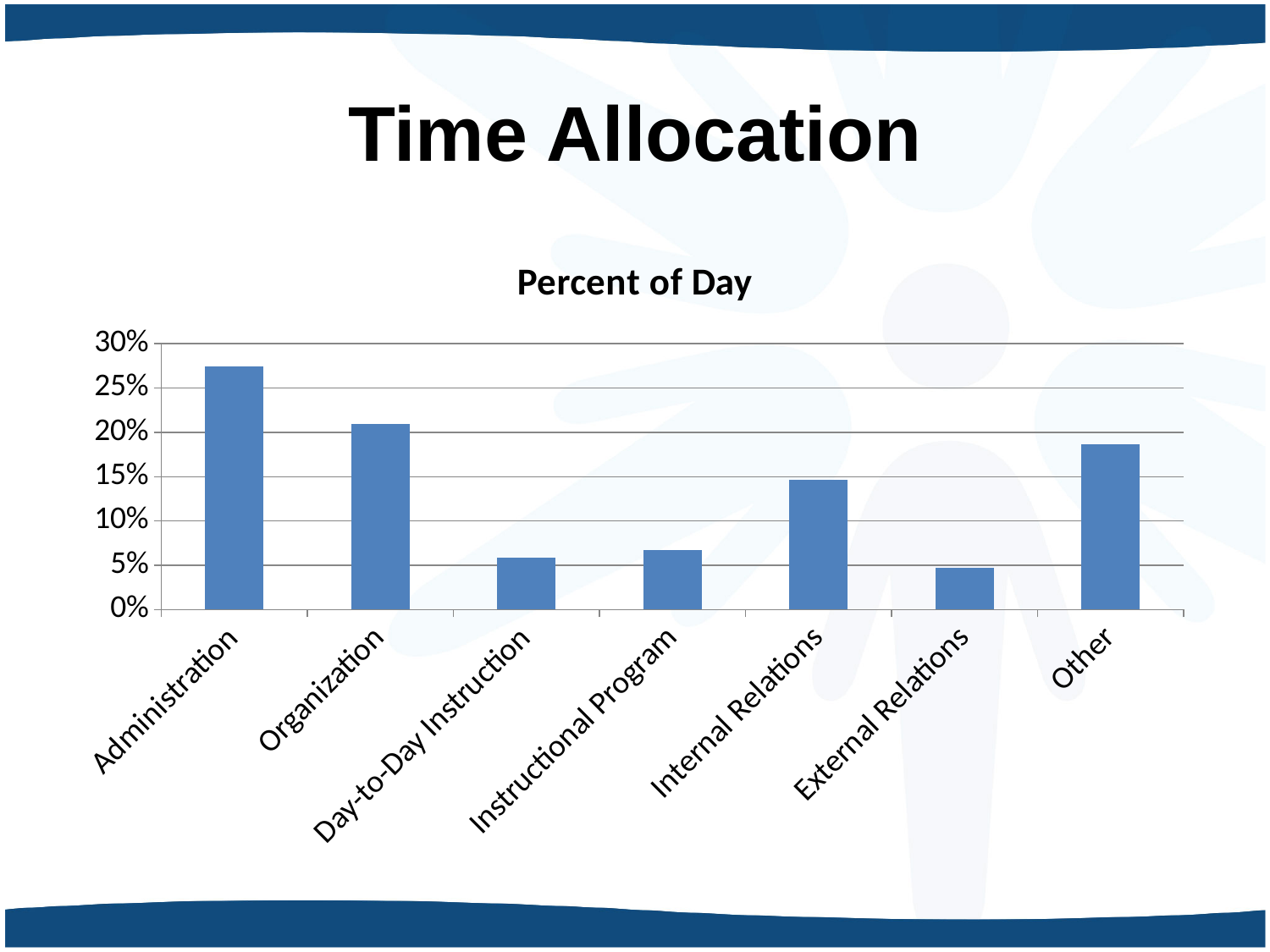
Is the value for Internal Relations greater or less than 10%? greater Which category has the highest percent of day? Administration What kind of chart is shown on the slide? bar chart What is the title of the chart? Percent of Day Which is larger, the value for Internal Relations or the value for Instructional Program? Internal Relations How many categories are shown on the x axis of the chart? 7 Which is larger, the value for Organization or the value for Other? Organization Is the value for Day-to-Day Instruction greater or less than 10%? less Is the value for Other greater or less than 15%? greater Which category has the lowest percent of day? External Relations